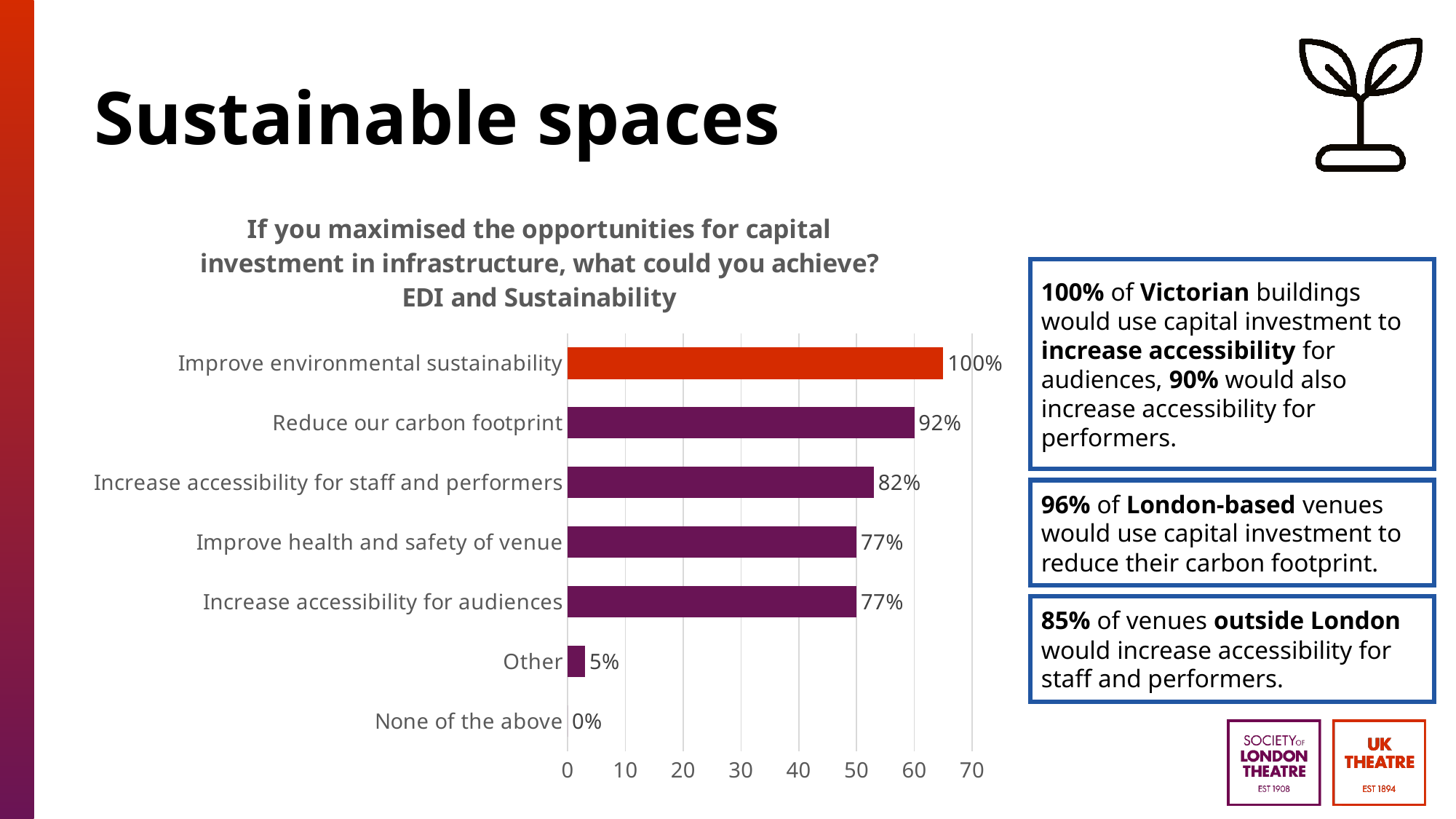
Which is larger: the value for 'Reduce our carbon footprint' or the value for 'Increase accessibility for staff and performers'? Reduce our carbon footprint How many categories are plotted in the chart? 7 What percentage is shown for 'Increase accessibility for staff and performers'? 82% Which category has the lowest value in the chart? None of the above Which bar in the chart is coloured differently (orange-red) from the others? Improve environmental sustainability What percentage is shown for 'Other'? 5% What percentage is shown for 'None of the above'? 0% What is the difference in percentage points between 'Improve health and safety of venue' and 'Other'? 72 Which category has the highest value in the chart? Improve environmental sustainability What kind of chart is shown on the slide? Bar chart What percentage is shown for 'Reduce our carbon footprint'? 92% What is the difference in percentage points between 'Improve environmental sustainability' and 'Reduce our carbon footprint'? 8